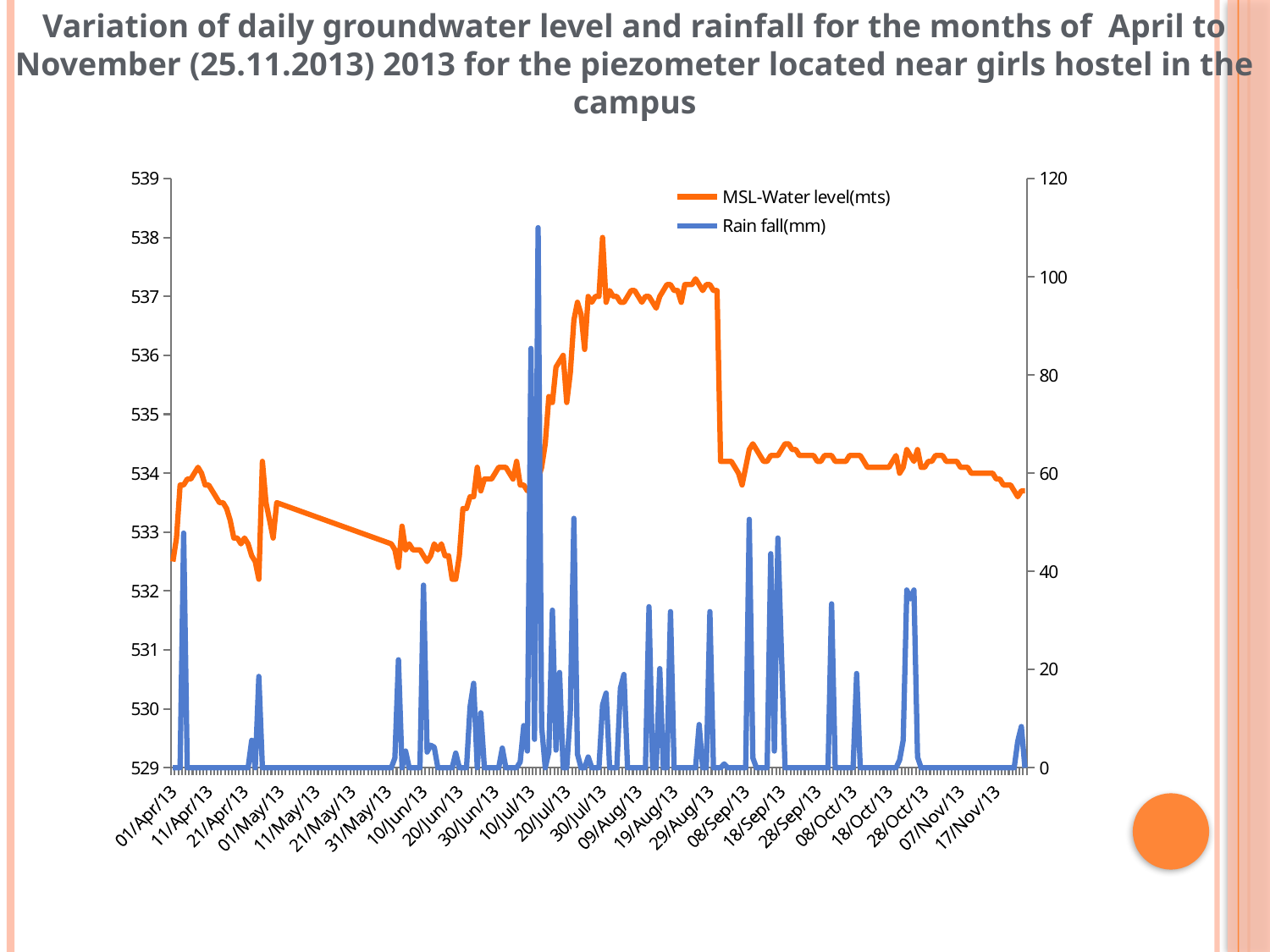
Is the peak MSL-Water level (around 30/Jul/13) greater or less than 537? greater Is the MSL-Water level at 01/Apr/13 greater or less than 533 on the left axis? less Is the highest rainfall spike (just after 10/Jul/13) greater or less than 100 mm on the right axis? greater Does the MSL-Water level rise or fall between 30/Jun/13 and 30/Jul/13? rise Is the MSL-Water level higher at 09/Aug/13 or at 08/Sep/13? 09/Aug/13 Does the MSL-Water level rise or fall between 01/May/13 and 31/May/13? fall In which month does the tallest rainfall spike occur? July 2013 What colour is the Rain fall(mm) series drawn in? blue What kind of chart is shown on the slide? line chart What are the two series named in the legend? MSL-Water level(mts) and Rain fall(mm) How many series does the legend list? 2